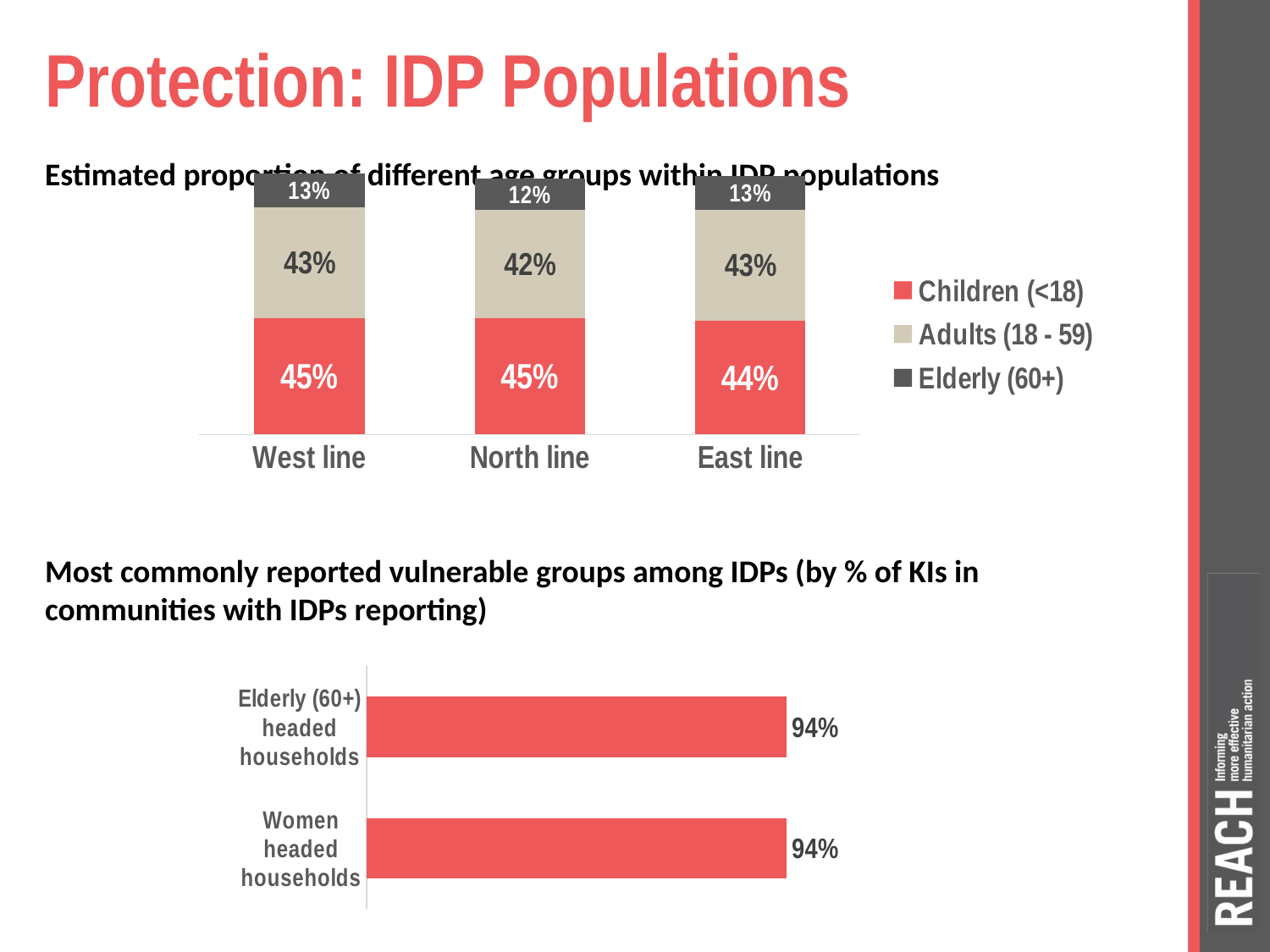
In the bottom chart, what is the value for Women headed households? 94% In the top chart, what is the difference between the Adults (18 - 59) value and the Elderly (60+) value on the West line? 30% In the top chart, how many series does the legend list? 3 In the top chart, which line has the lowest value for Elderly (60+)? North line In the bottom chart, how many vulnerable groups are shown? 2 In the top chart, what is the value for Elderly (60+) on the East line? 13% In the top chart, which line has the lowest value for Children (<18)? East line In the top chart, is the Children (<18) value larger on the North line or the East line? North line In the top chart, how many lines (categories) are shown on the x axis? 3 In the top chart, what is the value for Adults (18 - 59) on the North line? 42% In the top chart, what is the value for Children (<18) on the West line? 45% What kind of chart is the top chart? Stacked bar chart